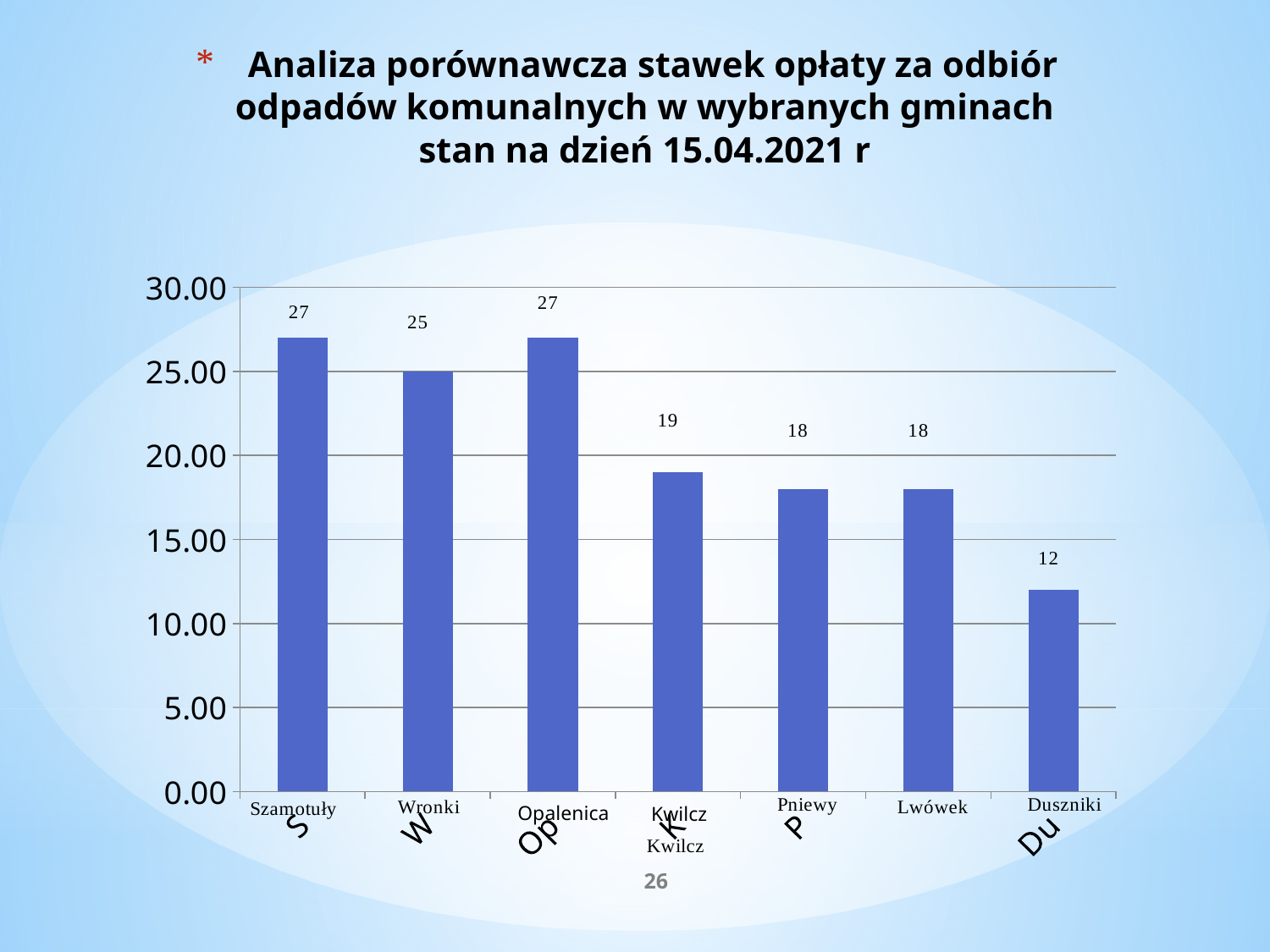
What is the value for Duszniki? 12 What is the value for Wronki? 25 What is the difference between the values for Wronki and Kwilcz? 6 Which is larger, the value for Wronki or the value for Pniewy? Wronki What kind of chart is shown on the slide? bar chart What is the difference between the values for Szamotuły and Duszniki? 15 How many categories are shown on the x axis? 7 What is the value for Opalenica? 27 Which category has the lowest value? Duszniki What is the highest value shown on the y axis? 30.00 What is the value for Kwilcz? 19 Is the value for Lwówek greater or less than 20.00? less